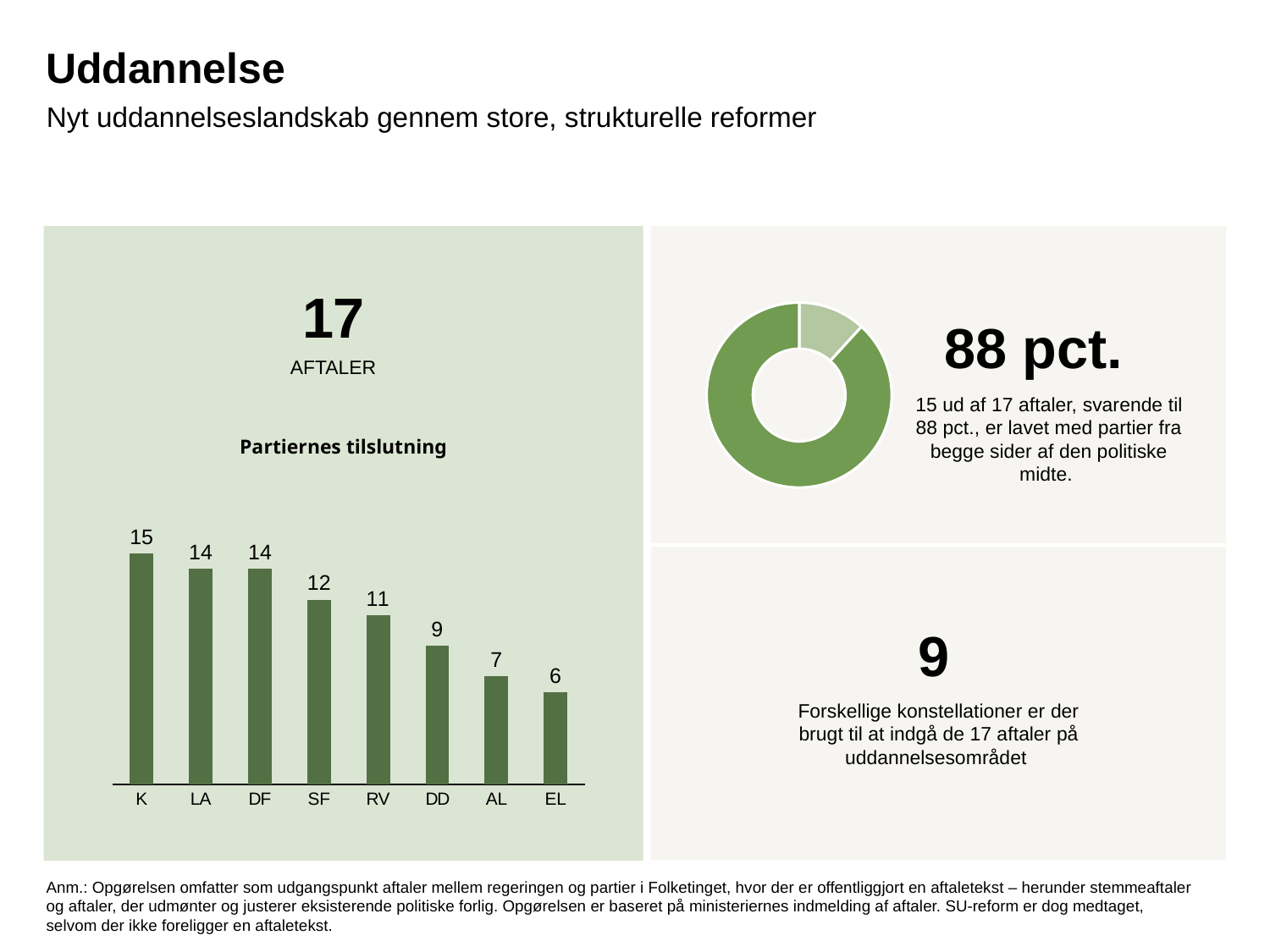
How many parties are shown in the 'Partiernes tilslutning' bar chart? 8 In the donut chart on the right, what share of the agreements does the large dark green slice represent? 88 pct. In the 'Partiernes tilslutning' bar chart, what is the value for RV? 11 In the 'Partiernes tilslutning' bar chart, what is the difference between the values for K and EL? 9 In the 'Partiernes tilslutning' bar chart, do the values rise or fall from left to right? fall In the 'Partiernes tilslutning' bar chart, what is the value for K? 15 In the 'Partiernes tilslutning' bar chart, which party has the highest value? K What kind of chart is 'Partiernes tilslutning'? bar chart In the 'Partiernes tilslutning' bar chart, which party has the lowest value? EL In the 'Partiernes tilslutning' bar chart, what is the value for DD? 9 In the 'Partiernes tilslutning' bar chart, which is larger, the value for RV or the value for DD? RV In the 'Partiernes tilslutning' bar chart, what is the difference between the values for SF and AL? 5